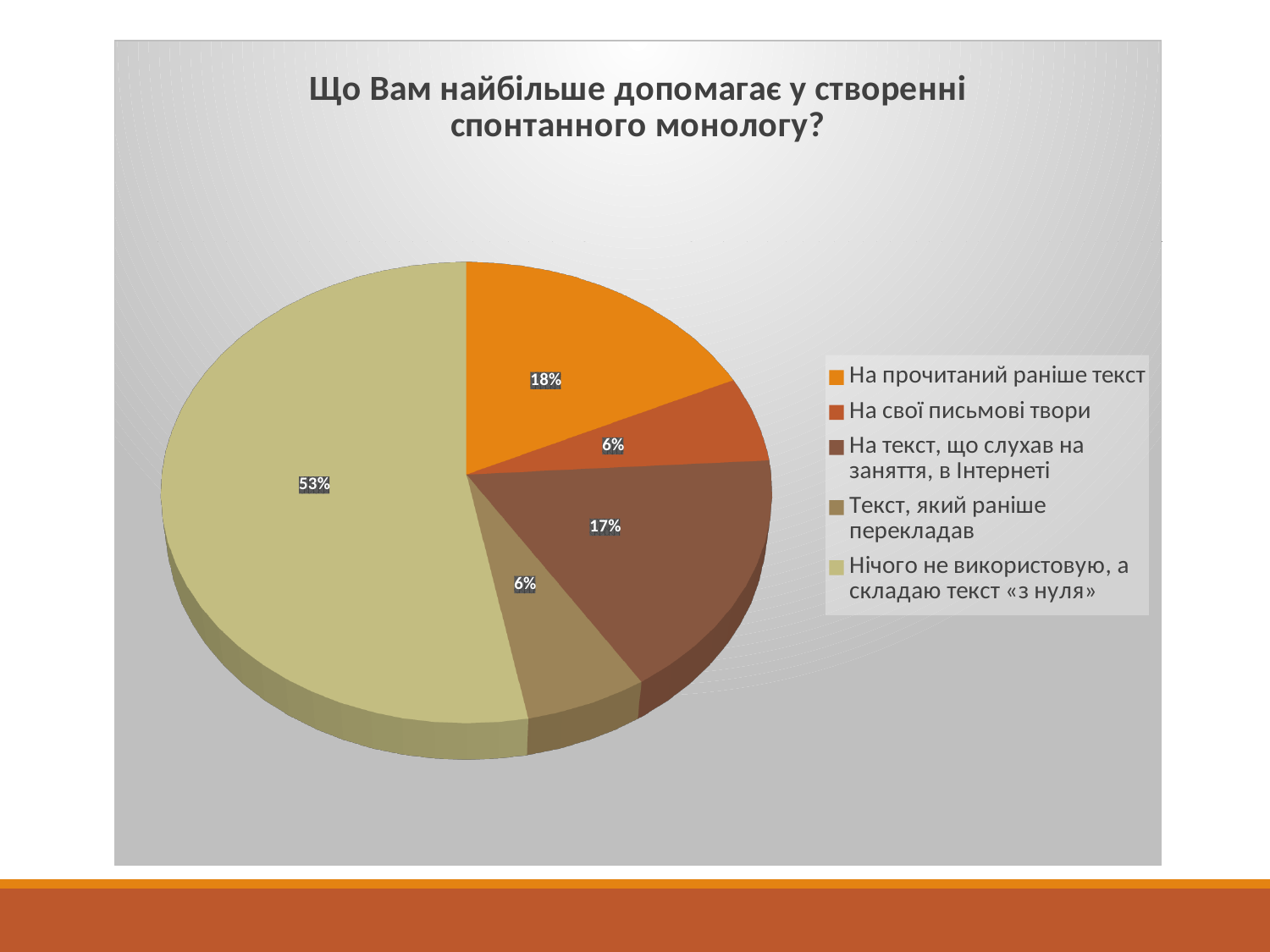
What kind of chart is shown on the slide? Pie chart What is the title of the chart? Що Вам найбільше допомагає у створенні спонтанного монологу? Which category has the largest slice of the pie? Нічого не використовую, а складаю текст «з нуля» What share of the pie is labelled "Нічого не використовую, а складаю текст «з нуля»"? 53% What share of the pie is labelled "На текст, що слухав на занятті, в Інтернеті"? 17% What colour is the slice for "На прочитаний раніше текст"? Orange How many categories does the legend list? 5 What share of the pie is labelled "Текст, який раніше перекладав"? 6% What is the difference in percentage points between "Нічого не використовую, а складаю текст «з нуля»" and "На прочитаний раніше текст"? 35 Which is larger: the slice for "На прочитаний раніше текст" or the slice for "На свої письмові твори"? На прочитаний раніше текст